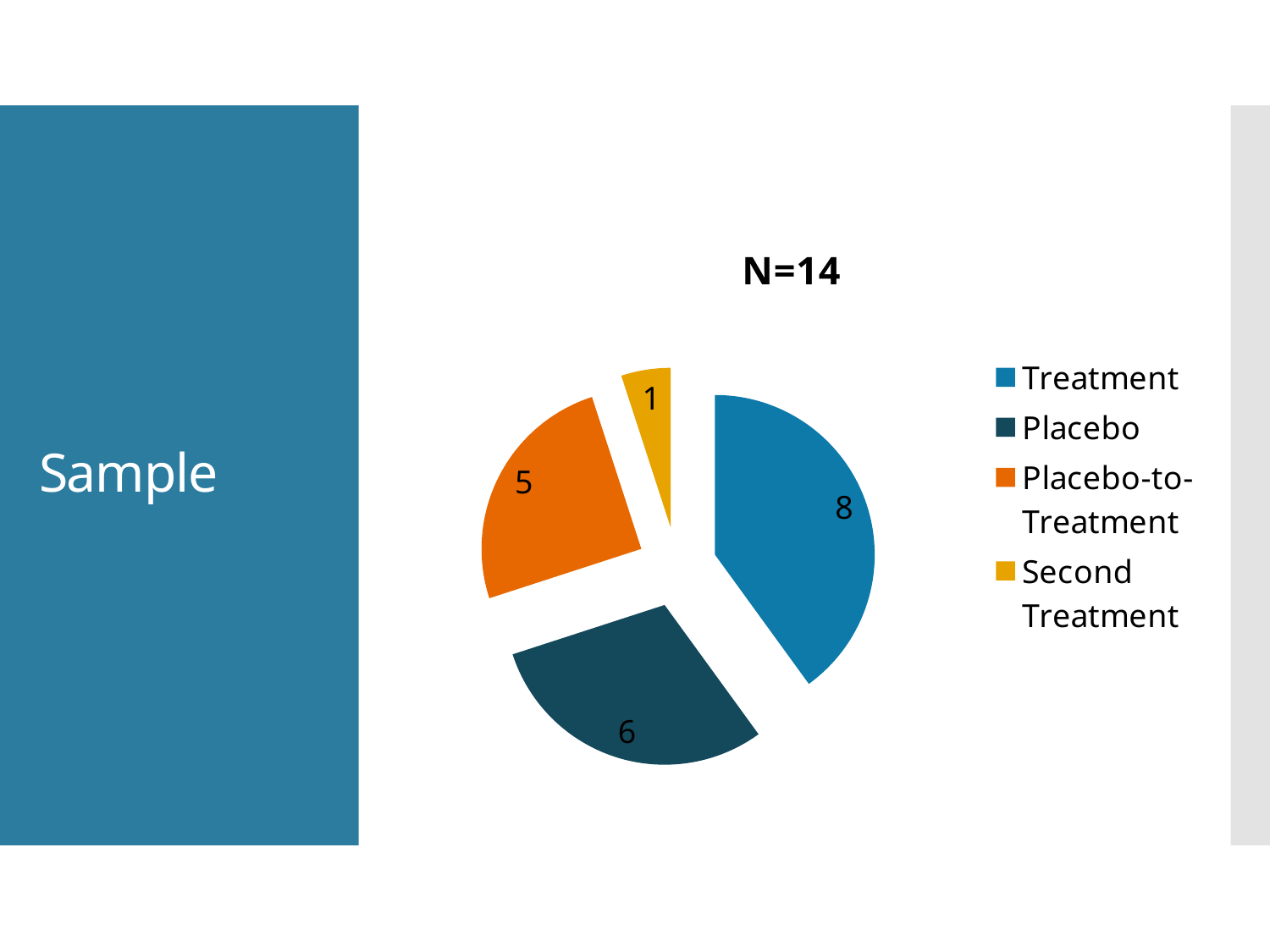
What is the value of the Placebo slice? 6 What is the difference between the Treatment and Placebo values? 2 What colour is the Placebo-to-Treatment slice? orange How many categories does the pie chart have? 4 Which category has the largest slice? Treatment What is the value of the Treatment slice? 8 What type of chart is shown on the slide? pie chart Which category has the smallest slice? Second Treatment What is the title of the chart? N=14 What is the value of the Placebo-to-Treatment slice? 5 Which is larger, the Placebo slice or the Placebo-to-Treatment slice? Placebo What is the value of the Second Treatment slice? 1